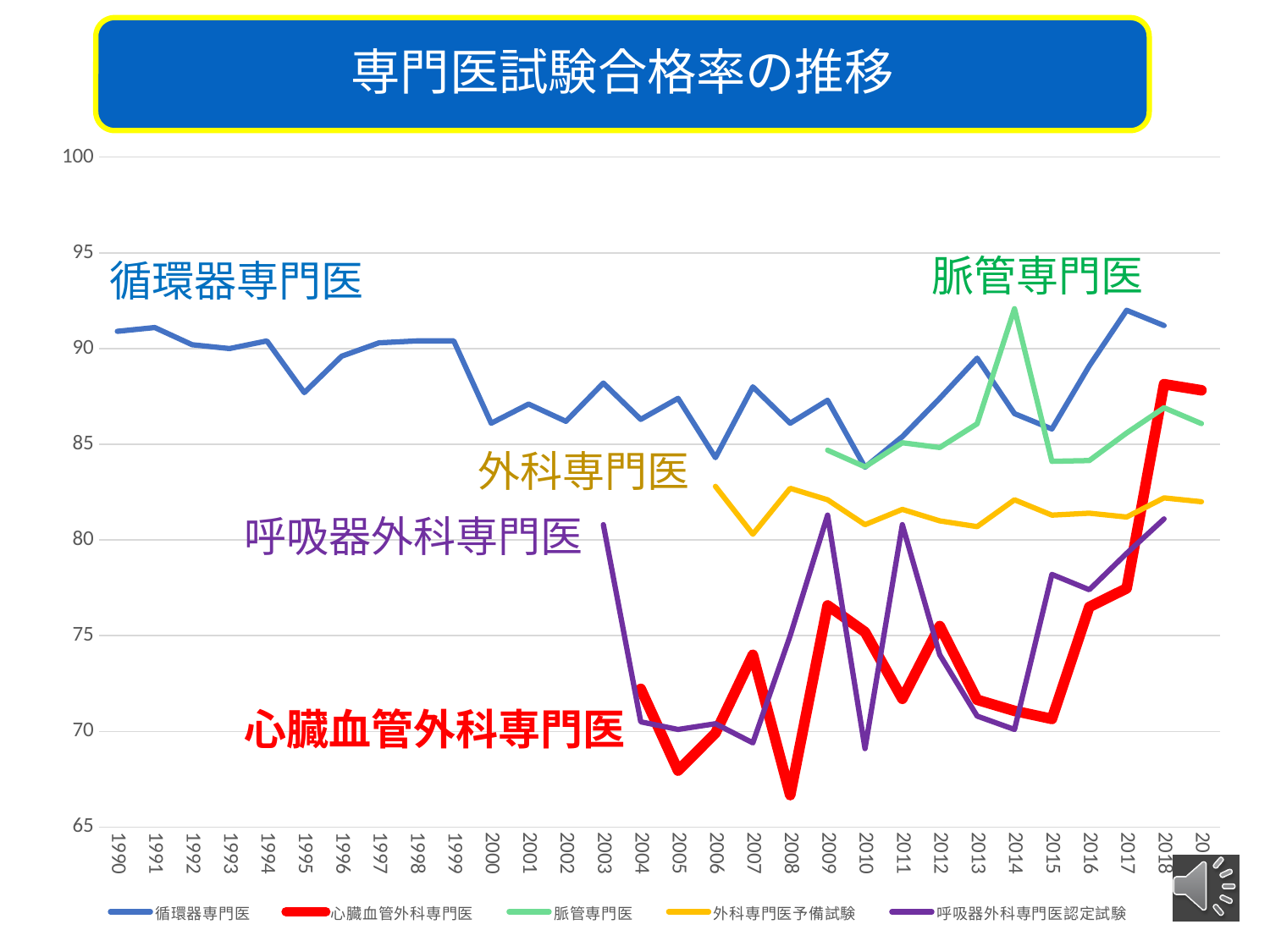
What is the title of the chart? 専門医試験合格率の推移 Is the value for 循環器専門医 in 1995 greater or less than 90? less Which series has the highest value in 2014? 脈管専門医 Which series has the lowest value in 2008? 心臓血管外科専門医 Is the value for 脈管専門医 in 2014 greater or less than 90? greater How many series does the legend list? 5 In 2018, which is larger: the value for 循環器専門医 or the value for 心臓血管外科専門医? 循環器専門医 Is the value for 循環器専門医 in 2017 greater or less than 90? greater What kind of chart is shown on the slide? line chart Which series is drawn with the thick red line? 心臓血管外科専門医